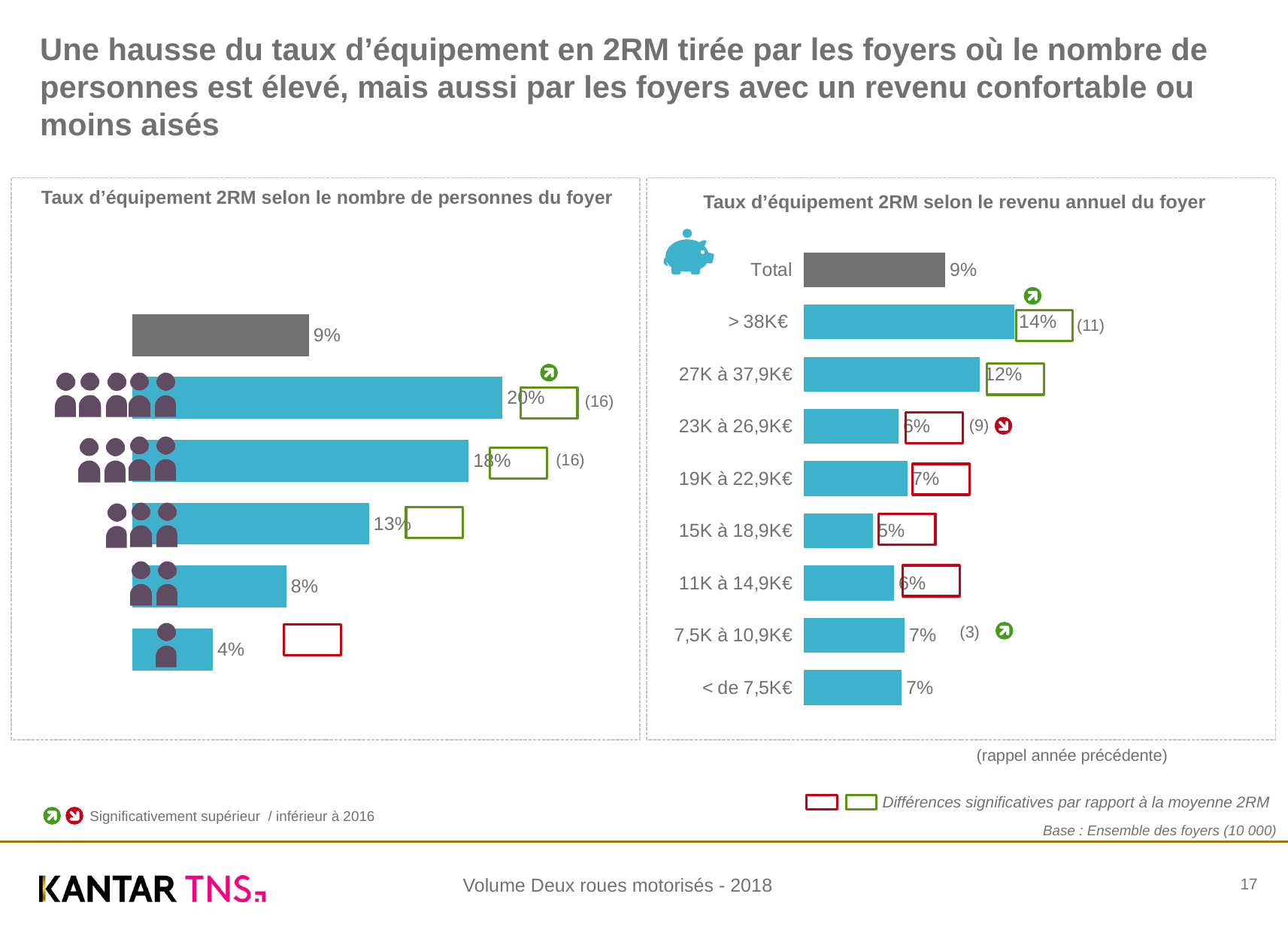
In the chart 'Taux d'équipement 2RM selon le nombre de personnes du foyer', what is the value for the bar with five person icons (five-person households)? 20% In the chart 'Taux d'équipement 2RM selon le revenu annuel du foyer', what is the value for '15K à 18,9K€'? 5% In the chart 'Taux d'équipement 2RM selon le revenu annuel du foyer', what is the difference between the values for '> 38K€' and '23K à 26,9K€'? 8% In the chart 'Taux d'équipement 2RM selon le revenu annuel du foyer', which income bracket has the highest value? > 38K€ What kind of chart is 'Taux d'équipement 2RM selon le nombre de personnes du foyer'? Bar chart In the chart 'Taux d'équipement 2RM selon le revenu annuel du foyer', which income bracket has the lowest value? 15K à 18,9K€ In the chart 'Taux d'équipement 2RM selon le revenu annuel du foyer', how many income brackets are shown, excluding the Total bar? 8 In the chart 'Taux d'équipement 2RM selon le revenu annuel du foyer', what is the value for '> 38K€'? 14% In the chart 'Taux d'équipement 2RM selon le revenu annuel du foyer', which is larger: the value for '27K à 37,9K€' or the value for '19K à 22,9K€'? 27K à 37,9K€ In the chart 'Taux d'équipement 2RM selon le nombre de personnes du foyer', what is the value for the bar with a single person icon (one-person households)? 4% In the chart 'Taux d'équipement 2RM selon le revenu annuel du foyer', what is the value for 'Total'? 9% In the chart 'Taux d'équipement 2RM selon le revenu annuel du foyer', what is the value for '27K à 37,9K€'? 12%